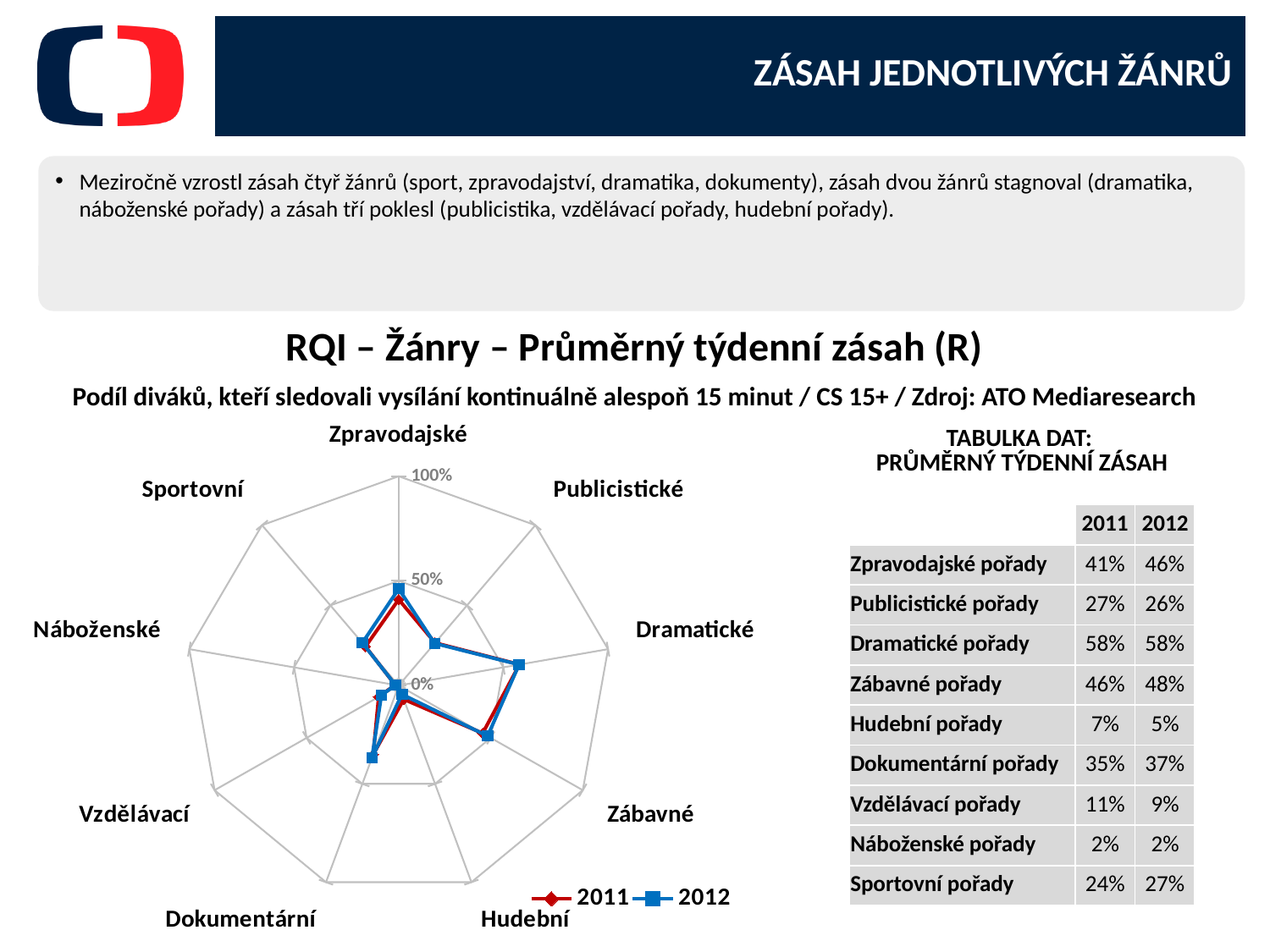
Is the 2012 value for Dramatické on the radar chart greater or less than 50%? greater How many series does the chart legend list? 2 What kind of chart is shown on the slide? Radar chart According to the data table, what was the average weekly reach of Dramatické pořady in 2012? 58% How many genre categories are plotted on the radar chart? 9 Which is larger: the 2012 reach of Sportovní pořady or the 2012 reach of Publicistické pořady? Sportovní pořady Which series is drawn in blue with square markers on the radar chart? 2012 By how many percentage points did the reach of Zpravodajské pořady change from 2011 to 2012? 5 percentage points What is the title of the chart? RQI – Žánry – Průměrný týdenní zásah (R) According to the data table, what was the average weekly reach of Zpravodajské pořady in 2011? 41% Which genre has the highest average weekly reach in 2012? Dramatické pořady Which genre has the lowest average weekly reach in 2011? Náboženské pořady